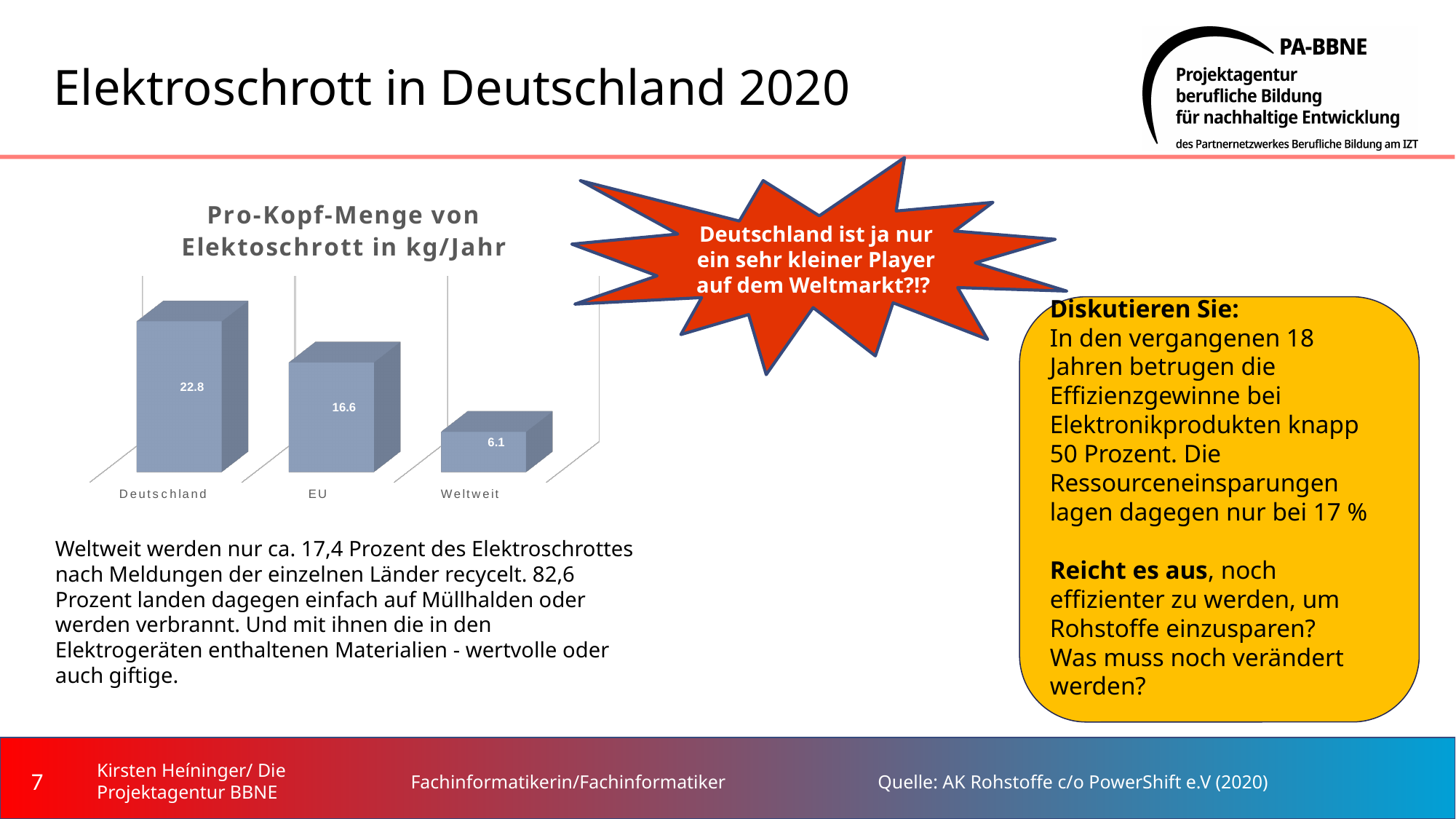
What is the difference between the values for EU and Weltweit? 10.5 What kind of chart is shown on the slide? bar chart What is the title of the chart? Pro-Kopf-Menge von Elektoschrott in kg/Jahr What is the value for Weltweit in the chart? 6.1 What is the value for Deutschland in the chart? 22.8 What is the value for EU in the chart? 16.6 Which category has the lowest value in the chart? Weltweit Which category has the highest value in the chart? Deutschland How many categories are shown in the chart? 3 Do the values rise or fall from left to right across the categories? fall Which is larger, the value for EU or the value for Weltweit? EU What is the difference between the values for Deutschland and EU? 6.2